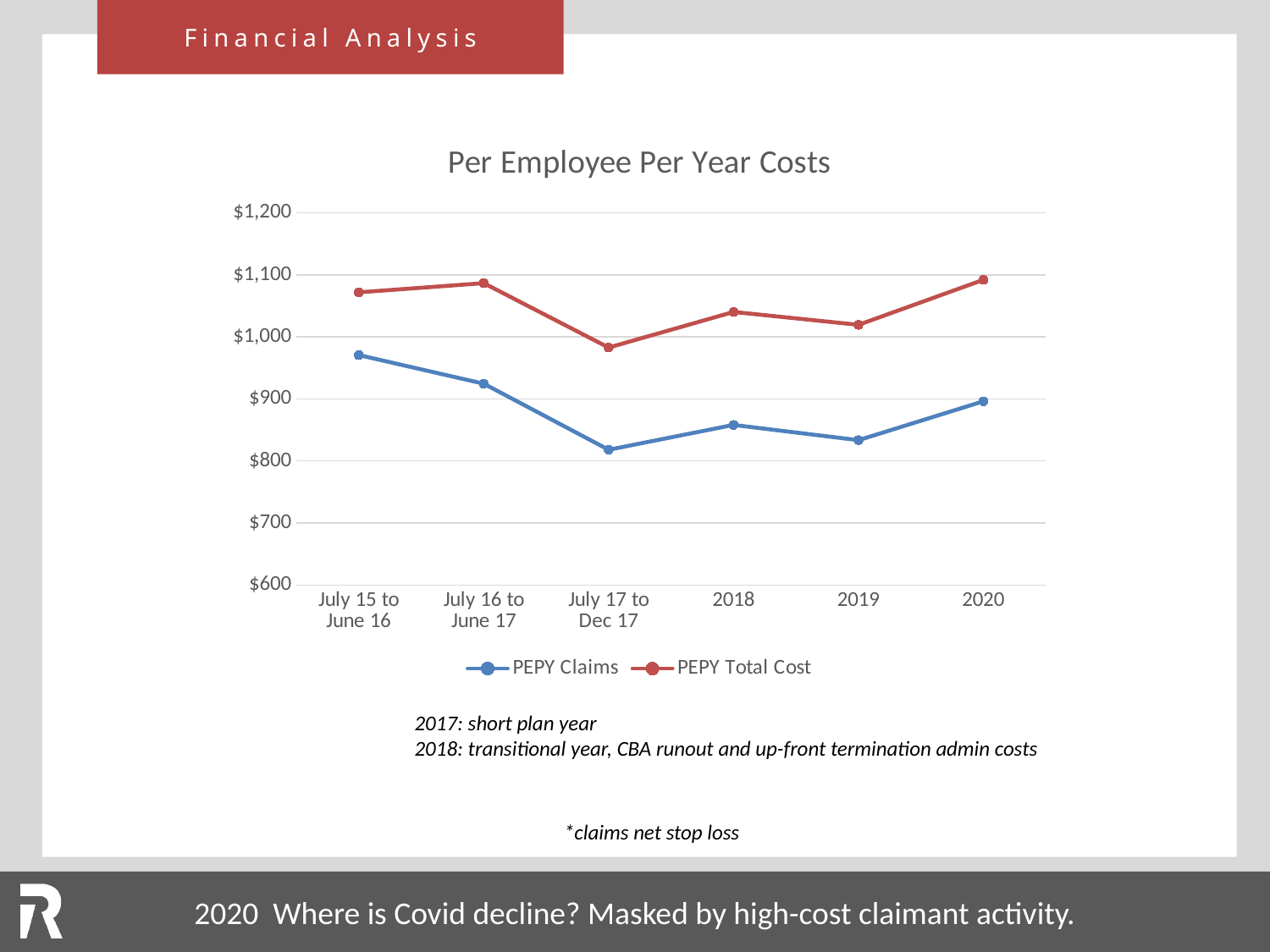
What is the title of the chart? Per Employee Per Year Costs Is the PEPY Claims value for July 15 to June 16 greater or less than $900? greater Is the PEPY Total Cost value for 2018 greater or less than $1,000? greater Is the PEPY Total Cost value for July 17 to Dec 17 greater or less than $1,000? less For which period is PEPY Total Cost lowest? July 17 to Dec 17 How many periods are shown along the x axis? 6 Which is larger for PEPY Claims: July 15 to June 16 or July 16 to June 17? July 15 to June 16 Does PEPY Claims rise or fall from July 15 to June 16 through July 17 to Dec 17? Fall How many series does the legend list? 2 Which series is drawn in red? PEPY Total Cost What kind of chart is shown on the slide? Line chart For which period is PEPY Claims highest? July 15 to June 16